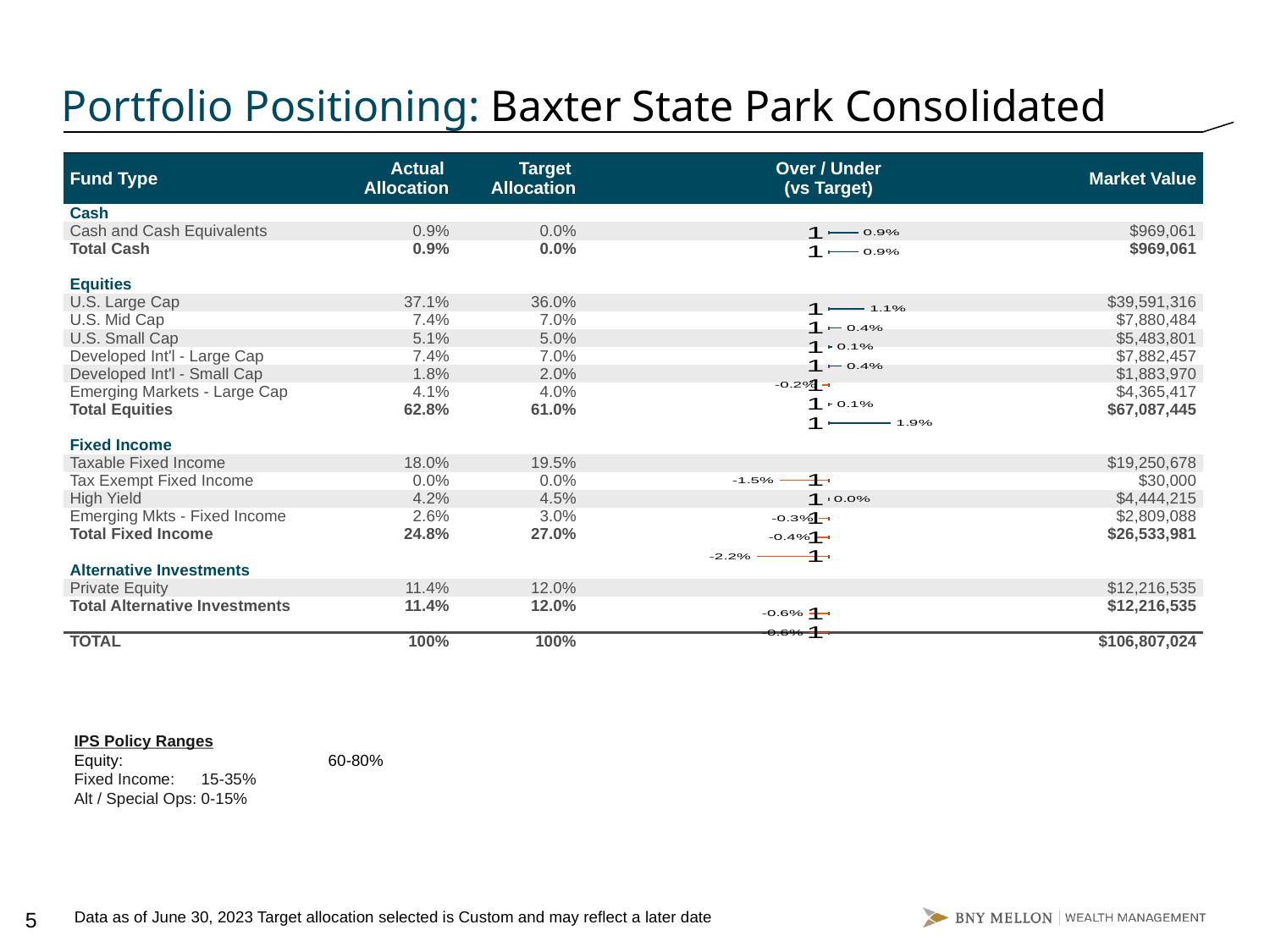
In the Over / Under (vs Target) chart, what is the difference between the largest data label (1.9%) and the smallest data label (-2.2%)? 4.1% Which column heading of the table does the bar chart sit under? Over / Under (vs Target) In the Over / Under (vs Target) chart, how many bars carry the data label -0.6%? 2 What kind of chart is embedded in the Over / Under (vs Target) column of the table? bar chart In the Over / Under (vs Target) chart, what is the lowest (most negative) value shown as a data label? -2.2% In the Over / Under (vs Target) chart, which bar extends further to the left: the one labeled -1.5% or the one labeled -2.2%? -2.2% What label is printed on the category axis next to every bar in the Over / Under (vs Target) chart? 1 In the Over / Under (vs Target) chart, which bar extends further to the right: the one labeled 1.1% or the one labeled 1.9%? 1.9% How many bars are plotted in the Over / Under (vs Target) chart? 16 In the Over / Under (vs Target) chart, how many bars carry the data label 0.9%? 2 In the Over / Under (vs Target) chart, what is the largest positive value shown as a data label? 1.9%